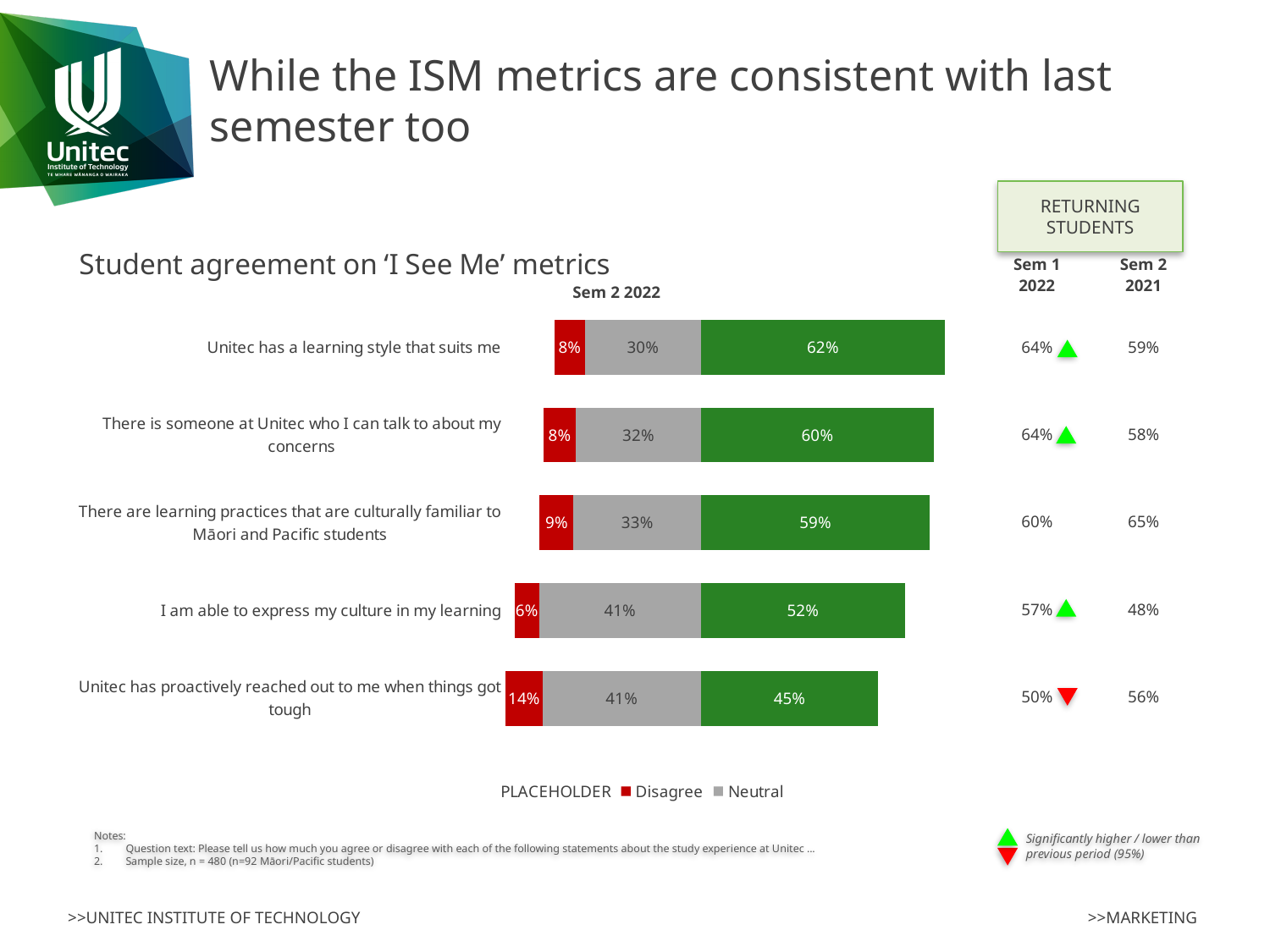
Which is larger: the Neutral value for 'There is someone at Unitec who I can talk to about my concerns' or the Neutral value for 'I am able to express my culture in my learning'? I am able to express my culture in my learning What is the green (agree) value for 'Unitec has a learning style that suits me' in Sem 2 2022? 62% How many statements (categories) are plotted in the chart? 5 What is the Neutral value for 'I am able to express my culture in my learning'? 41% What kind of chart is used to show student agreement on the 'I See Me' metrics? Stacked bar chart Which semester does the chart's data label above the bars refer to? Sem 2 2022 What is the total of the three segments in the bar for 'There are learning practices that are culturally familiar to Māori and Pacific students'? 101% What is the Disagree value for 'Unitec has proactively reached out to me when things got tough'? 14% Which statement has the lowest green (agree) value? Unitec has proactively reached out to me when things got tough What is the difference between the green (agree) values for 'Unitec has a learning style that suits me' and 'I am able to express my culture in my learning'? 10% Which statement has the highest Disagree value? Unitec has proactively reached out to me when things got tough How many series does the chart legend list? 3